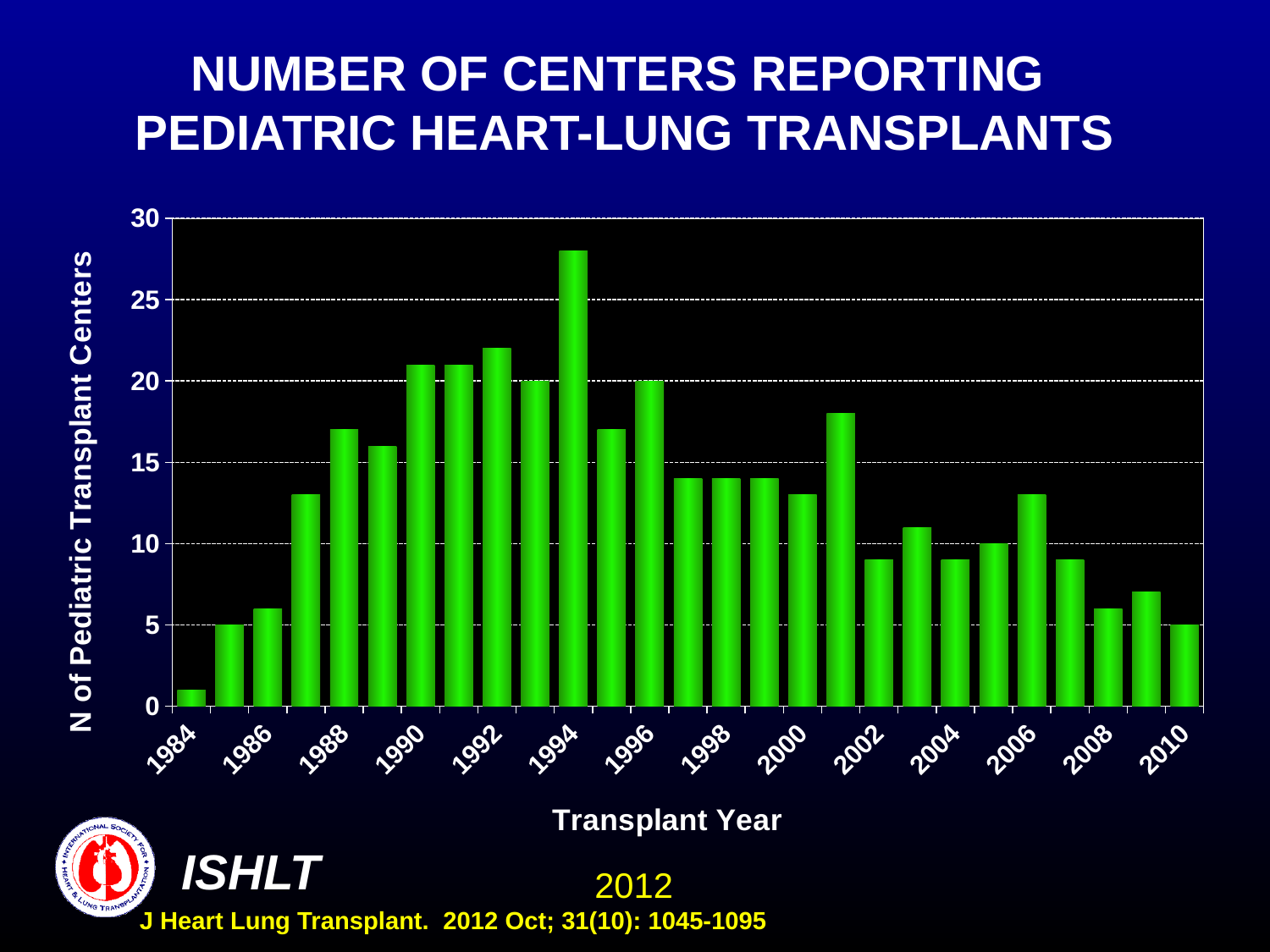
How many transplant years (bars) are plotted on the chart? 27 What is the title of the x axis? Transplant Year Is the number of centers reporting in 1994 greater or less than 25? greater Which transplant year has the lowest number of pediatric transplant centers reporting? 1984 Do the number of centers reporting generally rise or fall from 1994 to 2010? fall Which year had more centers reporting, 1990 or 2000? 1990 Which year had more centers reporting, 1994 or 1996? 1994 Is the number of centers reporting in 1990 greater or less than 20? greater Is the number of centers reporting in 2002 greater or less than 10? less Which transplant year has the highest number of pediatric transplant centers reporting? 1994 What kind of chart is shown on the slide? bar chart